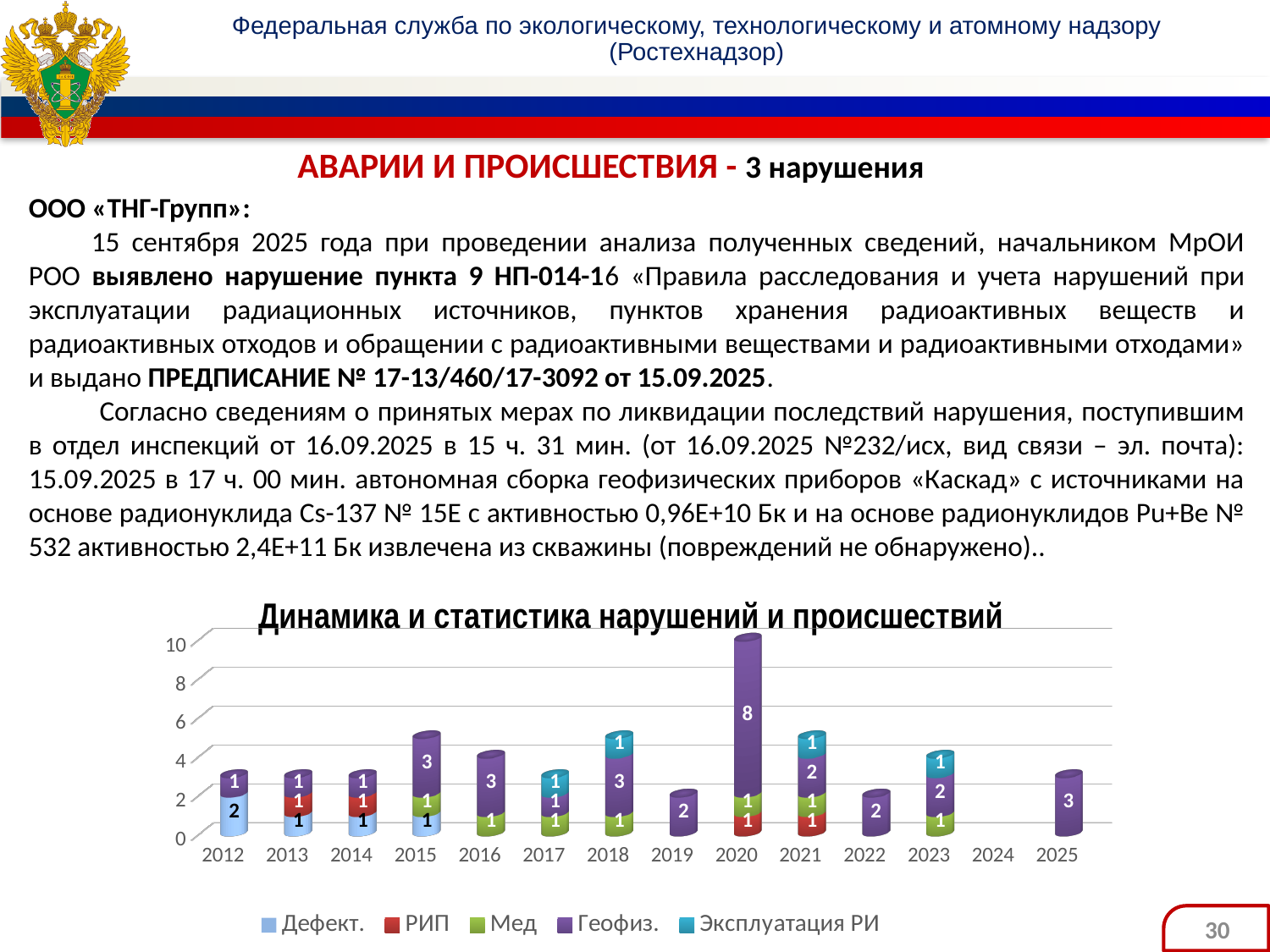
What is the value of the Дефект. segment for 2012? 2 What is the total of the stacked bar for 2020? 10 What is the difference between the Геофиз. value for 2020 and the Геофиз. value for 2025? 5 What kind of chart is shown on the slide? Stacked bar chart How many years are shown on the x axis of the chart? 14 What is the total of the stacked bar for 2015? 5 Which year has the tallest stacked bar? 2020 Which is larger: the Геофиз. value for 2016 or the Геофиз. value for 2019? 2016 What is the title of the chart? Динамика и статистика нарушений и происшествий What is the value of the Геофиз. segment for 2020? 8 How many series does the legend of the chart list? 5 What is the value of the Геофиз. segment for 2025? 3